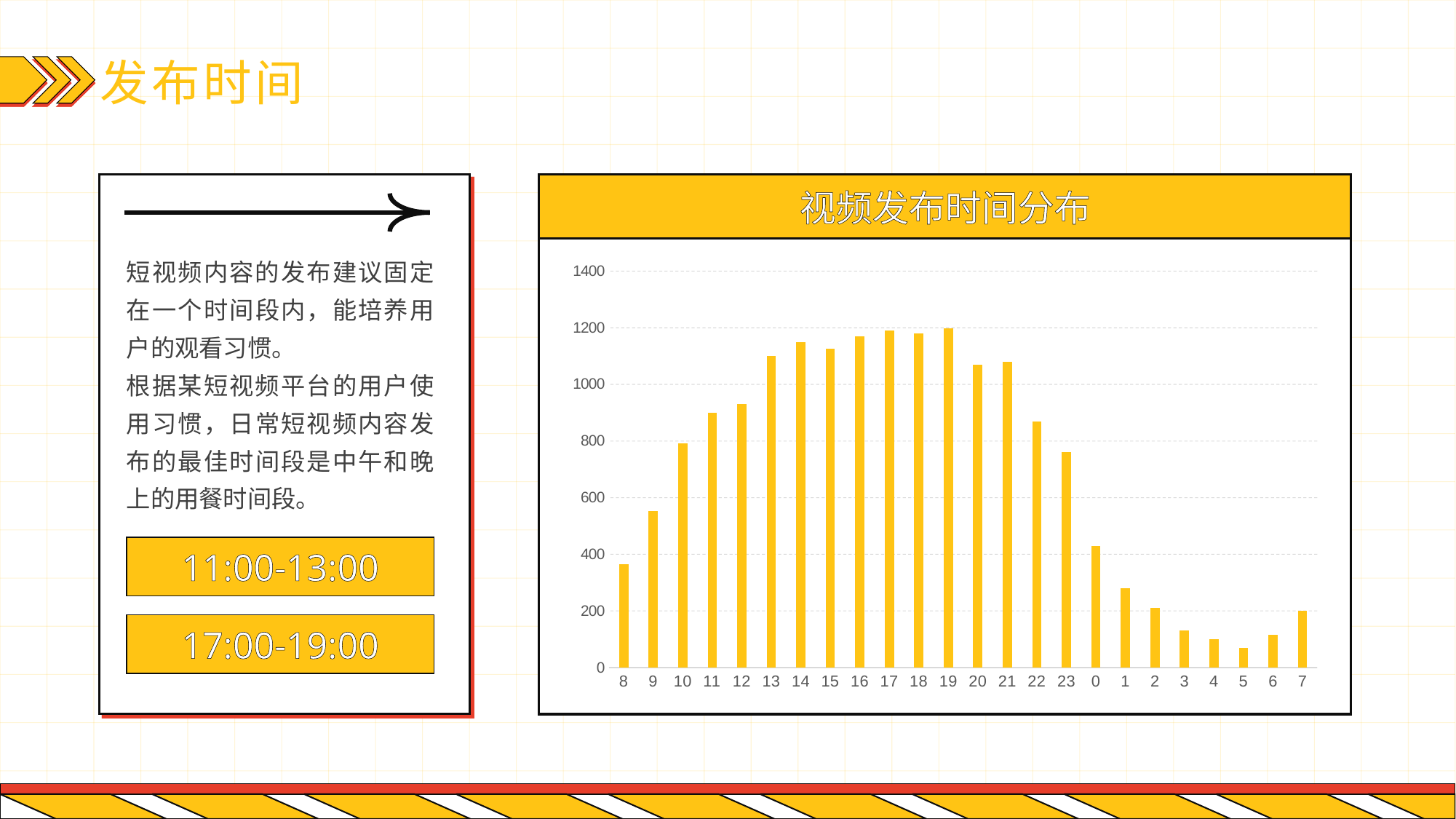
How many hour categories are plotted along the x axis? 24 Do the values rise or fall from hour 8 to hour 17? rise Is the value for hour 0 greater or less than 400? greater Which has a larger value, hour 9 or hour 22? 22 Which hour has the lowest value in the chart? 5 Is the value for hour 3 greater or less than 200? less Is the value for hour 8 greater or less than 400? less Which has a larger value, hour 12 or hour 20? 20 What type of chart is shown on the slide? bar chart What is the title of the chart? 视频发布时间分布